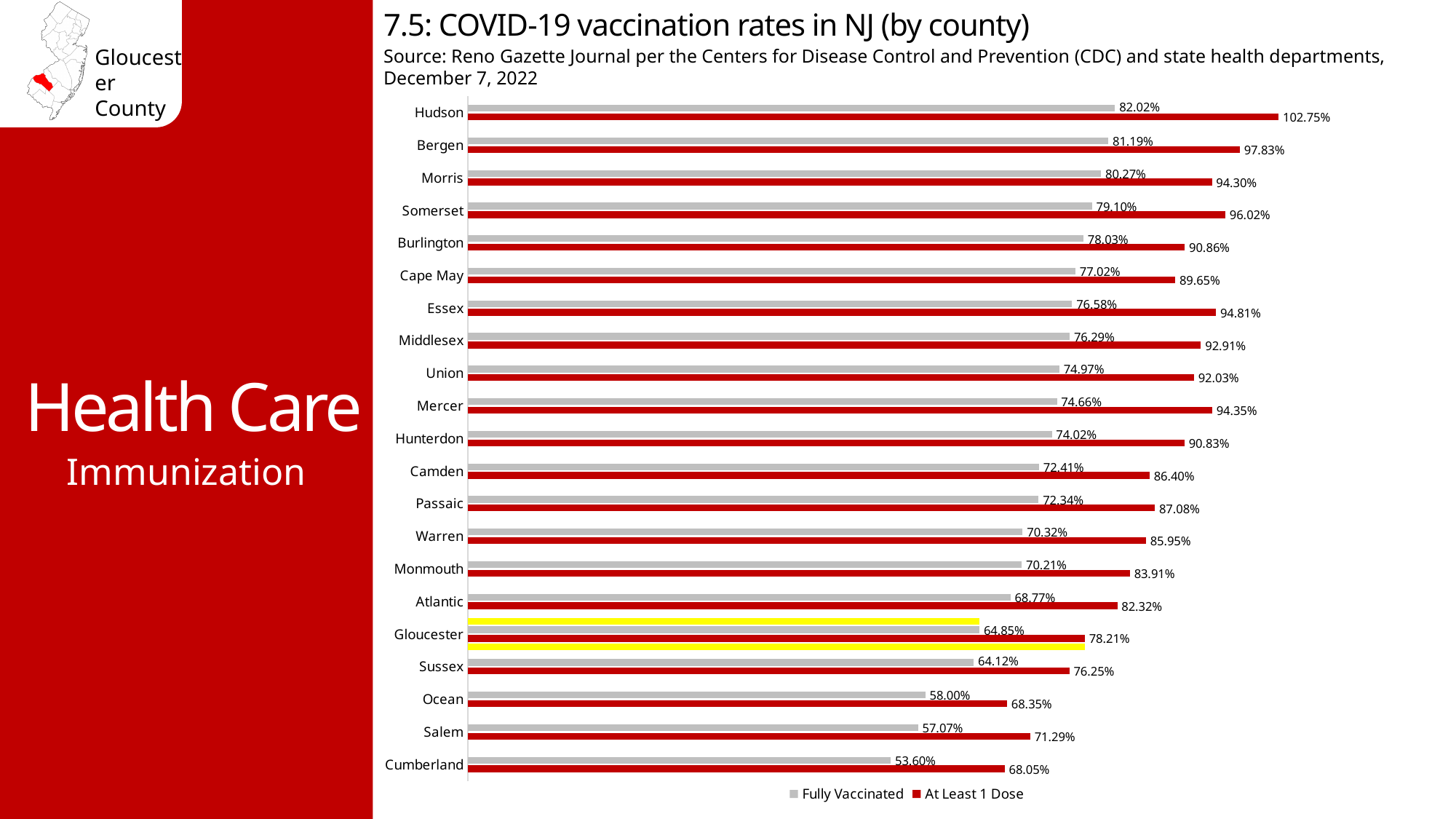
Which county has the highest At Least 1 Dose rate? Hudson Which county has the higher Fully Vaccinated rate, Morris or Ocean? Morris What is the At Least 1 Dose rate for Camden? 86.40% Which county has the lowest Fully Vaccinated rate? Cumberland What is the difference between Gloucester's At Least 1 Dose rate and its Fully Vaccinated rate? 13.36 percentage points What kind of chart is shown on the slide? bar chart What is the Fully Vaccinated rate for Cumberland? 53.60% What is the Fully Vaccinated rate for Gloucester? 64.85% Which series is shown in red in the chart? At Least 1 Dose How many counties are shown in the chart? 21 How many series does the legend list? 2 What is the At Least 1 Dose rate for Hudson? 102.75%